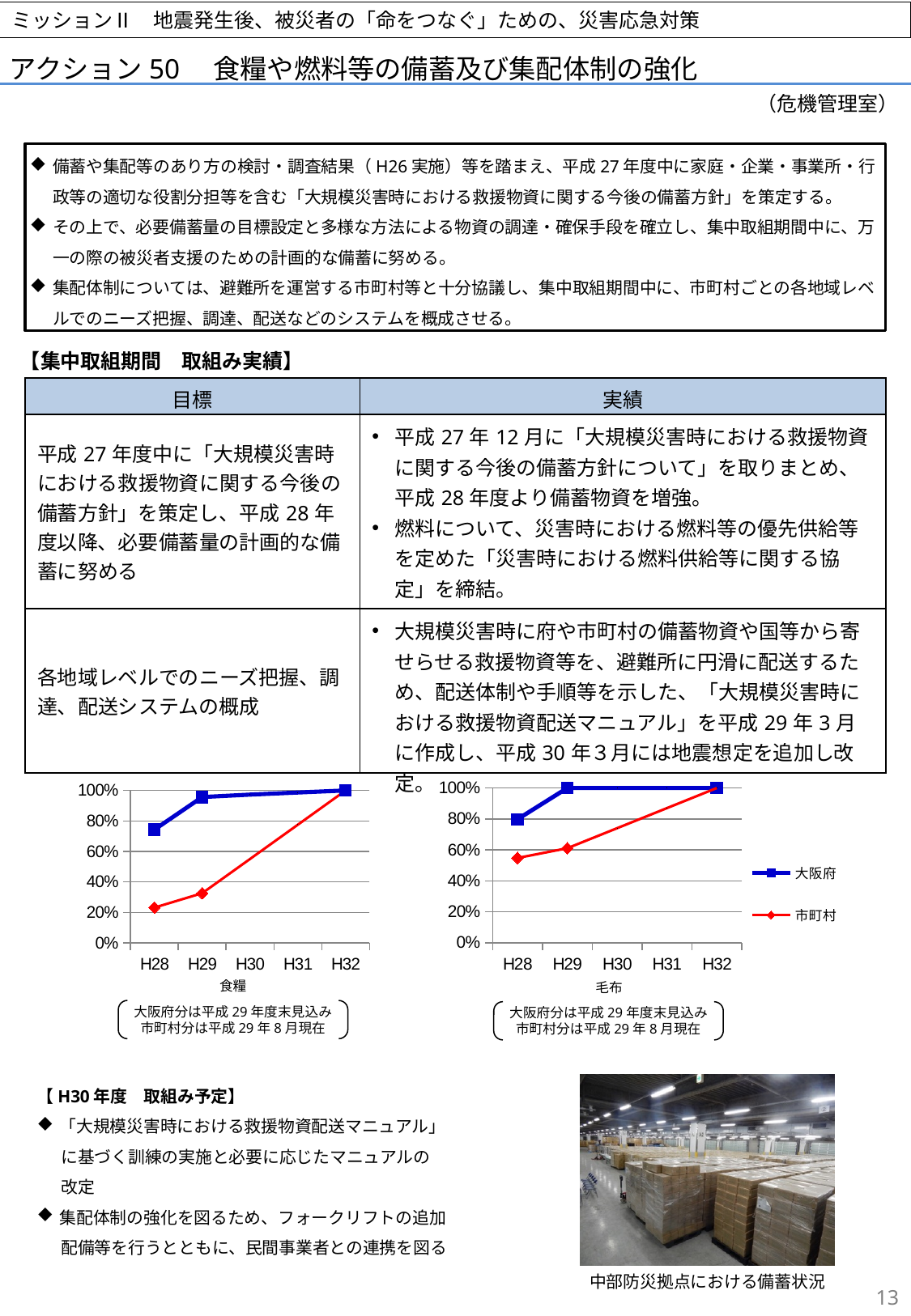
In the 食糧 chart at H29, which series has the larger value, 大阪府 or 市町村? 大阪府 In the 毛布 chart, is the value for 市町村 at H29 greater or less than 80%? less Which series is drawn in red with diamond markers in the charts? 市町村 In the 毛布 chart, what is the value for 大阪府 at H32? 100% How many fiscal-year categories are shown on the x axis of the 食糧 chart? 5 What kind of chart is the 食糧 chart on the left? line chart In the 食糧 chart, is the value for 大阪府 at H28 greater or less than 60%? greater In the 毛布 chart, does the 市町村 series rise or fall from H28 to H32? rise In the 食糧 chart, is the value for 市町村 at H28 greater or less than 40%? less How many series does the legend next to the 毛布 chart list? 2 In the 食糧 chart, what is the value for 市町村 at H32? 100%